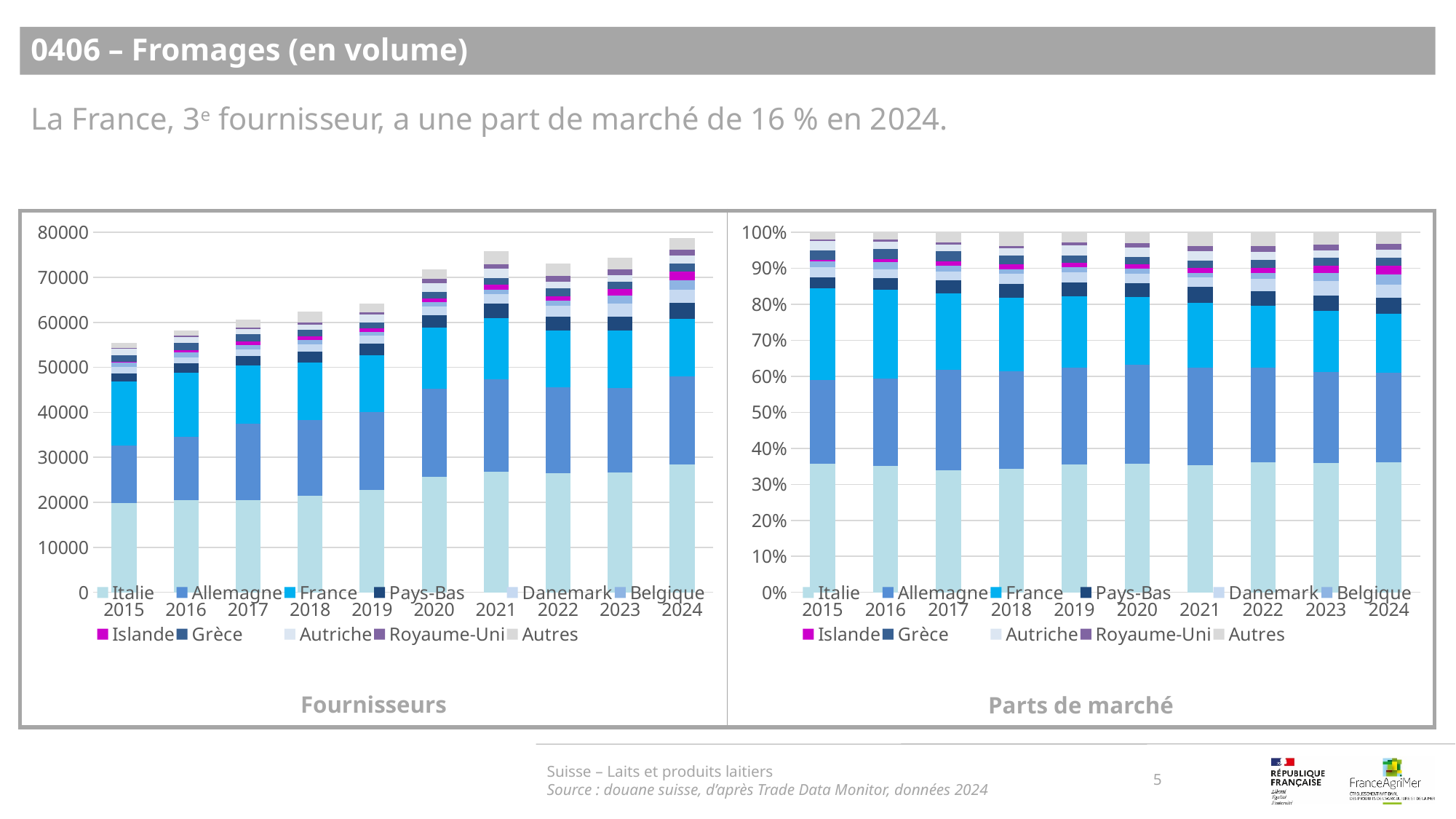
In the 'Fournisseurs' chart, which year has the highest total bar? 2024 In the 'Fournisseurs' chart, is the total for 2024 greater or less than 70000? greater In the 'Parts de marché' chart, is the share of Italie in 2015 greater or less than 30%? greater In the 'Parts de marché' chart, is the share of Italie in 2024 greater or less than 40%? less In the 'Fournisseurs' chart, do the total bars generally rise or fall from 2015 to 2024? rise In the 'Fournisseurs' chart, is the total for 2021 larger or smaller than the total for 2019? larger How many years are shown on the x axis of the 'Fournisseurs' chart? 10 What kind of chart is the 'Fournisseurs' chart on the left? stacked bar chart Which series is listed first in the legend of the 'Fournisseurs' chart? Italie How many series does the legend of the 'Parts de marché' chart list? 11 In the 'Fournisseurs' chart, which year has the lowest total bar? 2015